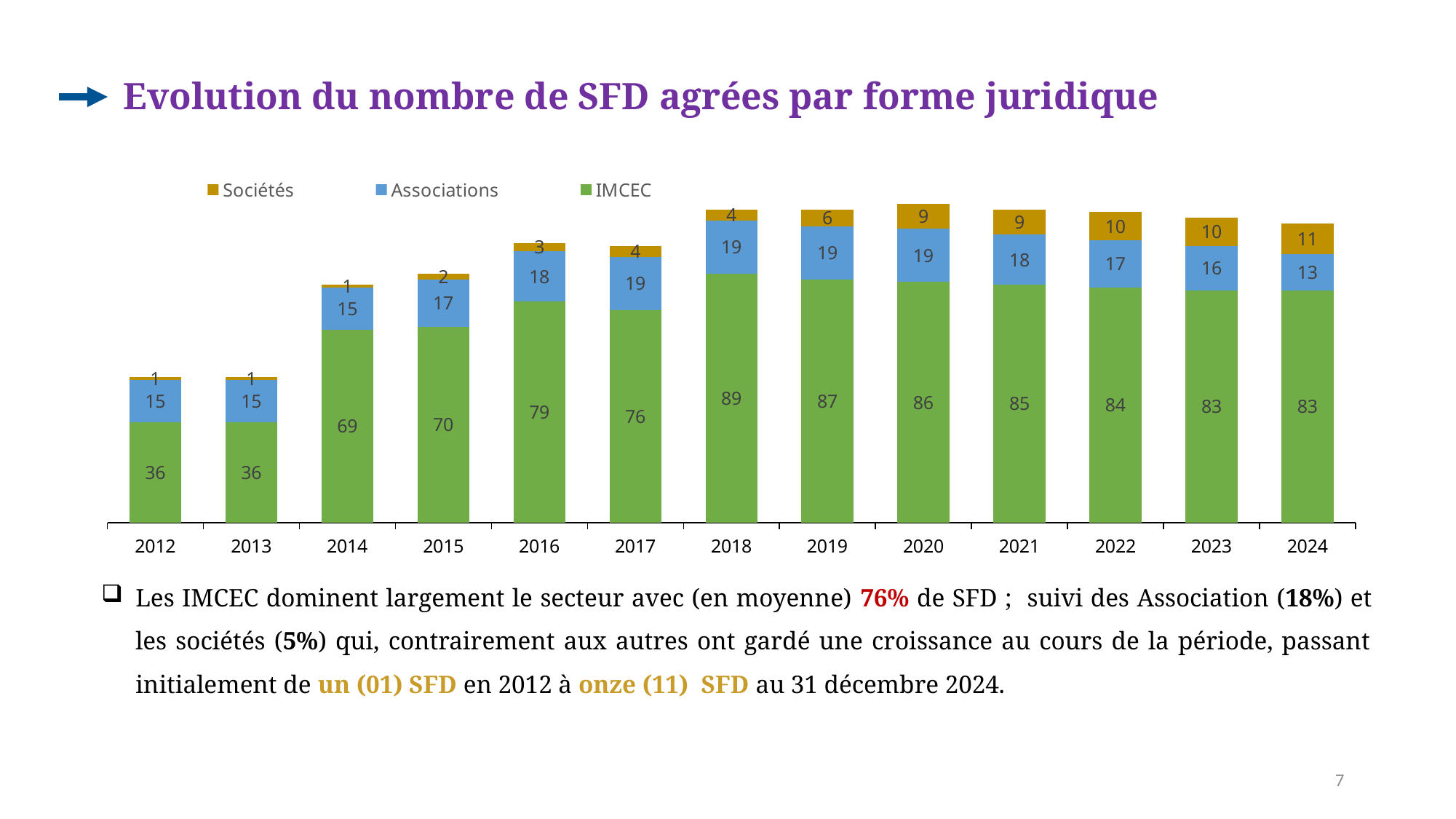
Which is larger, the Associations value for 2016 or for 2024? 2016 In which year is the IMCEC value highest? 2018 What is the difference between the IMCEC values for 2014 and 2012? 33 What is the Sociétés value for 2024? 11 What is the total of the stacked bar for 2020? 114 What is the Associations value for 2015? 17 How many series does the legend list? 3 How many years are shown on the x axis? 13 What is the IMCEC value for 2018? 89 Do the Sociétés values rise or fall from 2012 to 2024? Rise In which year is the Associations value lowest? 2024 What type of chart is shown on the slide? Stacked bar chart